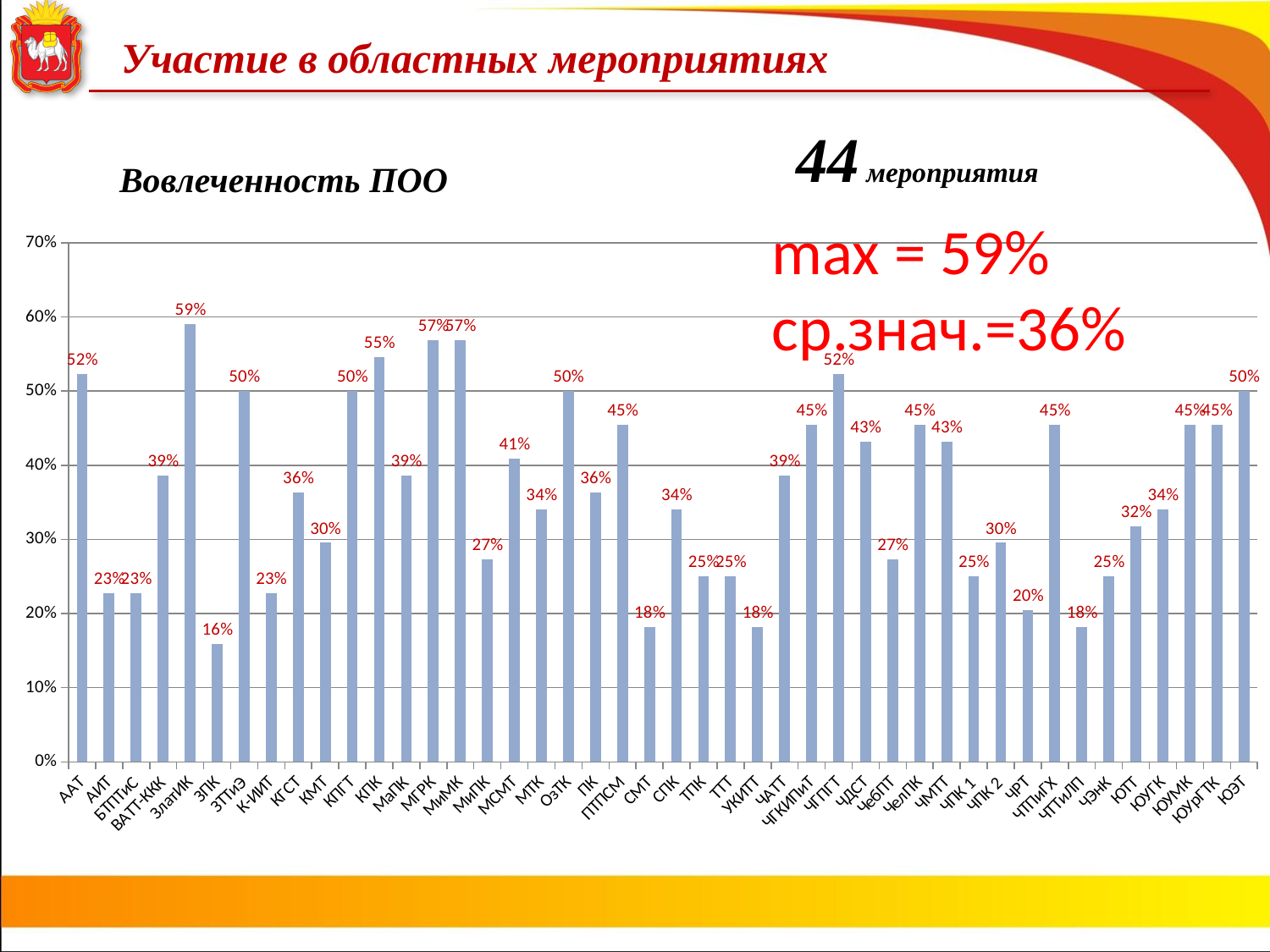
Is the value for ЧДСТ greater or less than 40%? greater What is the value for КПК? 55% Which is larger, the value for КГСТ or the value for КМТ? КГСТ What is the value for МСМТ? 41% What is the difference between the values for ААТ and АИТ? 29% What is the title of the chart? Вовлеченность ПОО Which category has the lowest value? ЗПК How many categories are shown on the x axis? 44 What is the value for ЧРТ? 20% What is the value for ЗлатИК? 59% Which category has the highest value? ЗлатИК What type of chart is shown on the slide? bar chart